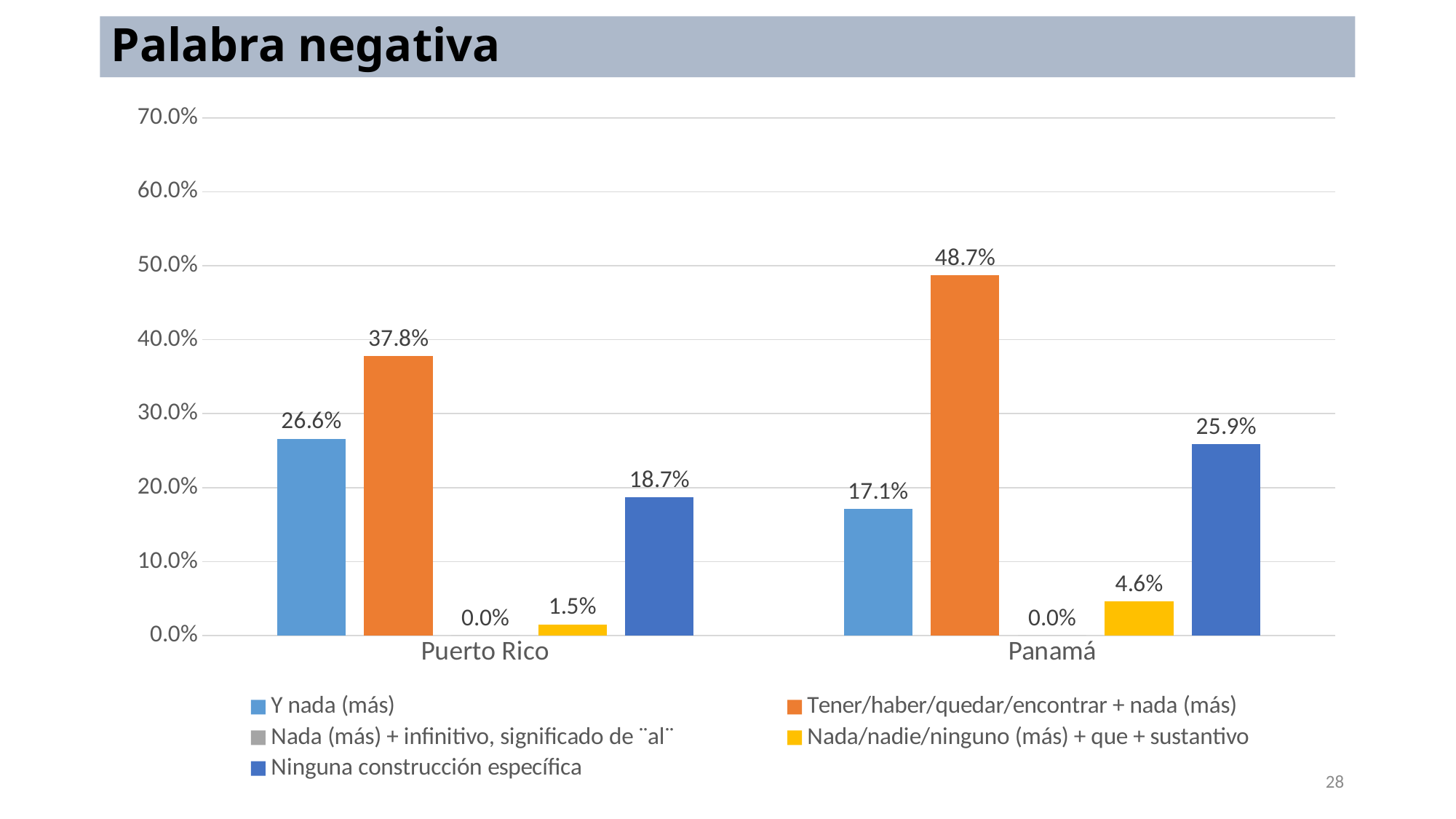
Which series has the highest value in Panamá? Tener/haber/quedar/encontrar + nada (más) Which series has the lowest value in Puerto Rico? Nada (más) + infinitivo, significado de ¨al¨ How many series does the legend list? 5 What is the difference between the "Tener/haber/quedar/encontrar + nada (más)" values for Panamá and Puerto Rico? 10.9% What is the value for "Y nada (más)" in Puerto Rico? 26.6% What is the value for "Nada/nadie/ninguno (más) + que + sustantivo" in Panamá? 4.6% Which is larger: "Y nada (más)" in Puerto Rico or "Y nada (más)" in Panamá? Puerto Rico What kind of chart is shown on the slide? Bar chart What is the value for "Tener/haber/quedar/encontrar + nada (más)" in Panamá? 48.7% What is the title of the slide? Palabra negativa What is the value for "Ninguna construcción específica" in Puerto Rico? 18.7% How many categories are shown on the x axis? 2